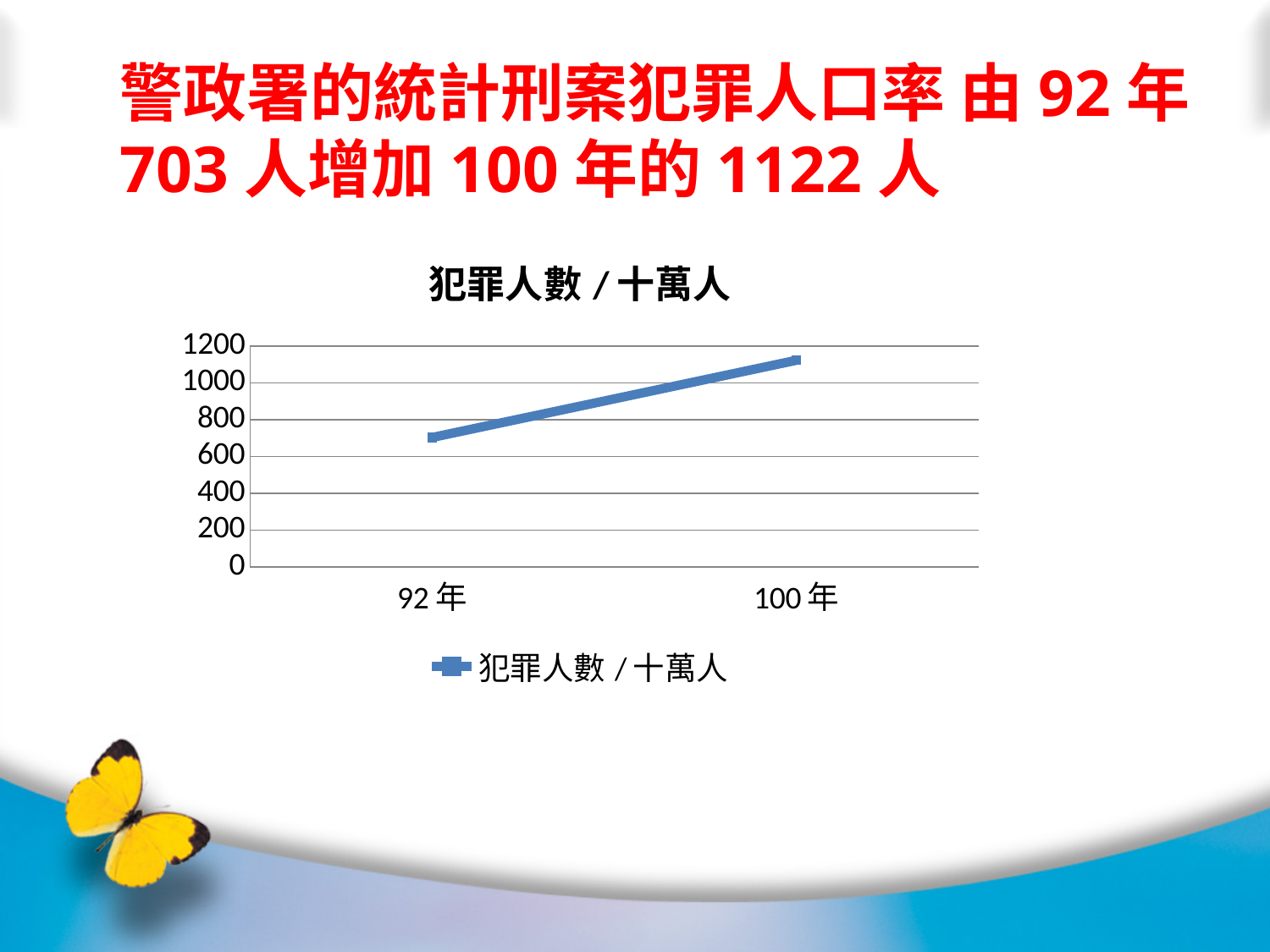
According to the slide, what is the value for 100 年? 1122 Which category has the highest value? 100 年 How many series does the legend list? 1 How many data points are plotted on the line? 2 Does the value rise or fall from 92 年 to 100 年? rise Is the value for 100 年 greater or less than 1000? greater Which year has the higher value, 92 年 or 100 年? 100 年 What is the title of the chart? 犯罪人數／十萬人 Which category has the lowest value? 92 年 What kind of chart is shown on the slide? line chart Is the value for 92 年 greater or less than 800? less According to the slide, what is the value for 92 年? 703